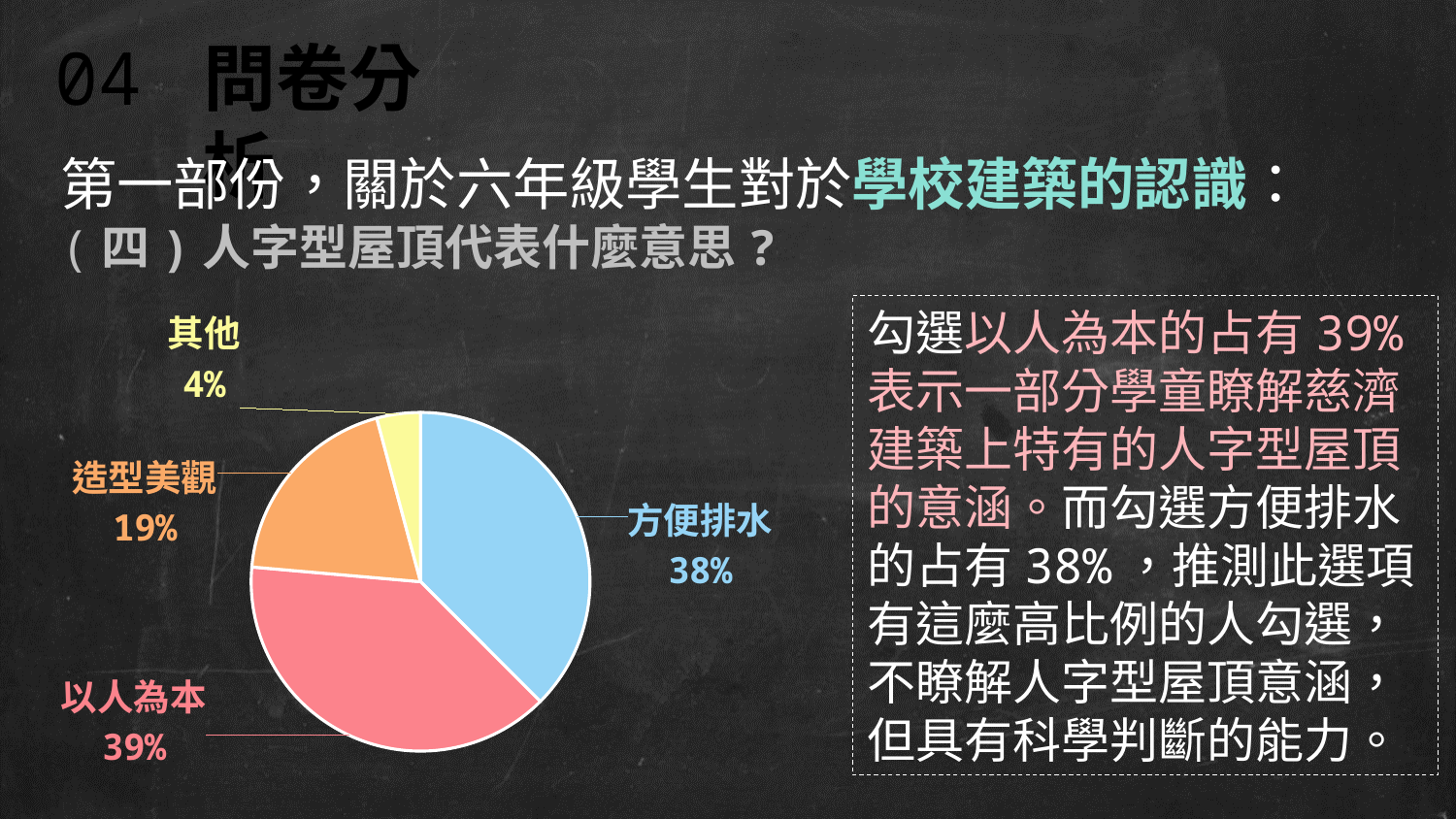
What percentage of students chose 方便排水 in the pie chart? 38% What percentage is shown for 其他 in the pie chart? 4% What is the difference in percentage points between 方便排水 and 造型美觀 in the pie chart? 19 What percentage is shown for 以人為本 in the pie chart? 39% Which is larger in the pie chart, 造型美觀 or 其他? 造型美觀 How many percentage points larger is 以人為本 than 方便排水 in the pie chart? 1 What kind of chart is shown on the slide? Pie chart How many categories does the pie chart show? 4 Which category has the smallest share in the pie chart? 其他 Which category has the largest share in the pie chart? 以人為本 What percentage is shown for 造型美觀 in the pie chart? 19% What colour is the 方便排水 slice in the pie chart? Blue